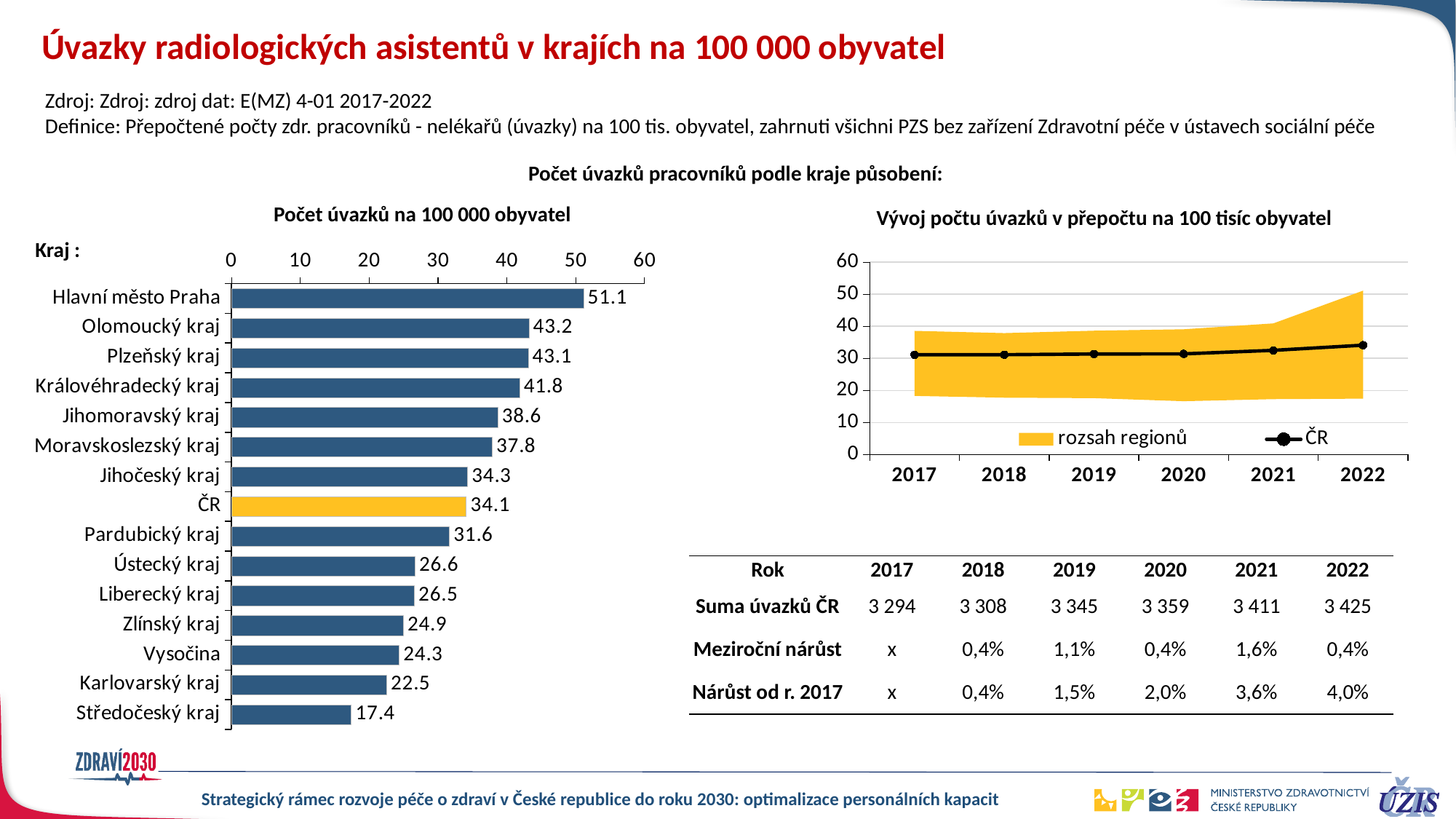
What type of chart is "Počet úvazků na 100 000 obyvatel"? Bar chart In the chart "Vývoj počtu úvazků v přepočtu na 100 tisíc obyvatel", is the ČR value for 2022 greater or less than 30? greater In the bar chart "Počet úvazků na 100 000 obyvatel", which is larger: Jihomoravský kraj or Moravskoslezský kraj? Jihomoravský kraj In the bar chart "Počet úvazků na 100 000 obyvatel", what is the value for Karlovarský kraj? 22.5 In the bar chart "Počet úvazků na 100 000 obyvatel", what is the difference between Hlavní město Praha and Středočeský kraj? 33.7 In the bar chart "Počet úvazků na 100 000 obyvatel", which region has the highest value? Hlavní město Praha In the chart "Vývoj počtu úvazků v přepočtu na 100 tisíc obyvatel", does the ČR line rise or fall from 2017 to 2022? rise How many series does the legend of the chart "Vývoj počtu úvazků v přepočtu na 100 tisíc obyvatel" list? 2 In the bar chart "Počet úvazků na 100 000 obyvatel", which region has the lowest value? Středočeský kraj How many bars (regions including ČR) are shown in the bar chart "Počet úvazků na 100 000 obyvatel"? 15 In the bar chart "Počet úvazků na 100 000 obyvatel", what is the value for Hlavní město Praha? 51.1 In the bar chart "Počet úvazků na 100 000 obyvatel", what is the value for ČR? 34.1